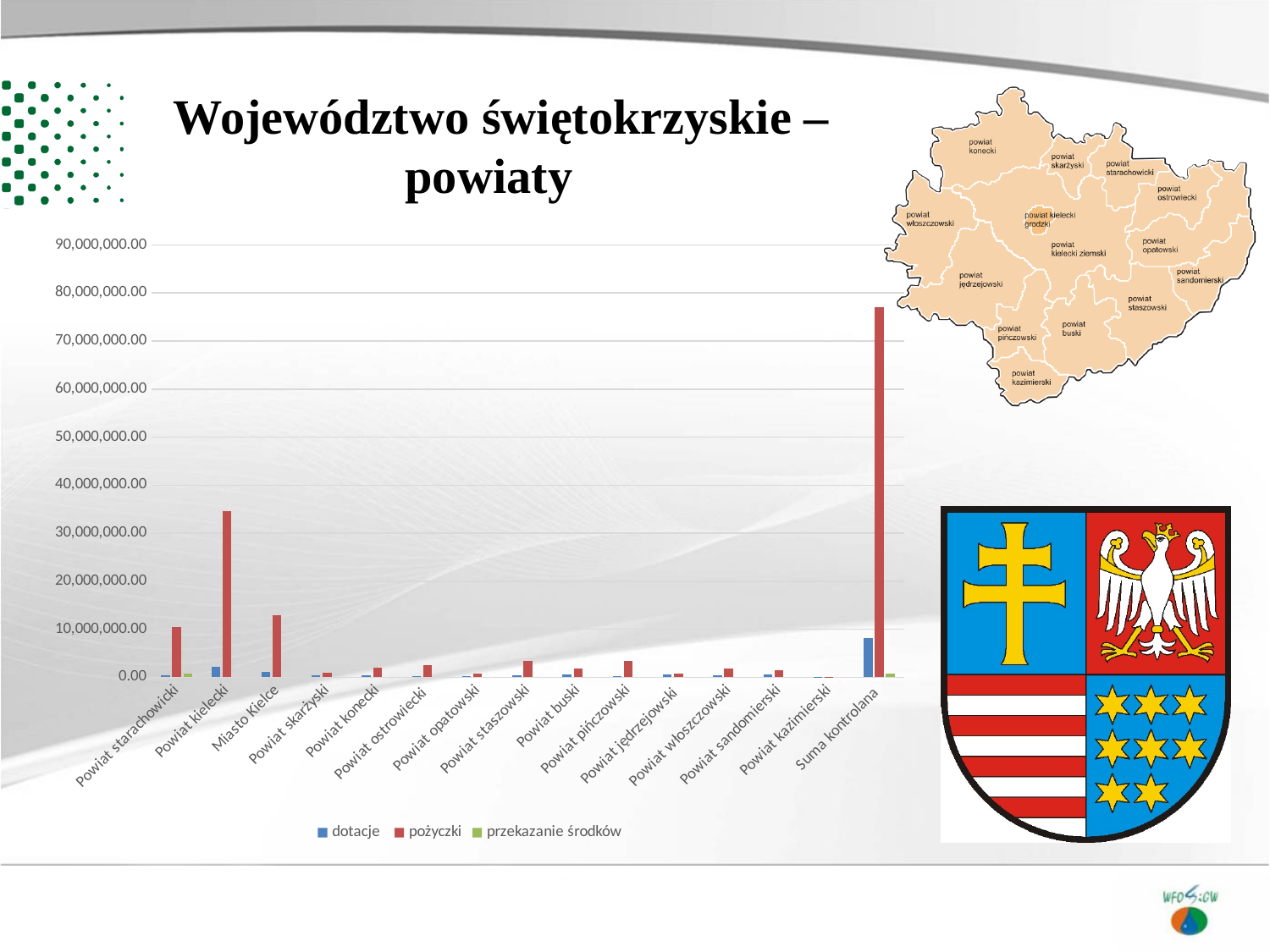
How many categories are shown along the x axis of the chart? 15 Excluding Suma kontrolana, which powiat has the tallest pożyczki bar? Powiat kielecki Which category has the tallest pożyczki bar in the chart? Suma kontrolana Is the pożyczki value for Powiat kielecki greater or less than 30,000,000.00? greater What is the highest value shown on the chart's y axis? 90,000,000.00 Which is larger, the pożyczki value for Powiat kielecki or for Miasto Kielce? Powiat kielecki Is the pożyczki value for Miasto Kielce greater or less than 10,000,000.00? greater What kind of chart is shown on the slide? bar chart How many series does the chart legend list? 3 Is the dotacje value for Suma kontrolana greater or less than 10,000,000.00? less Which series is shown in red in the chart? pożyczki